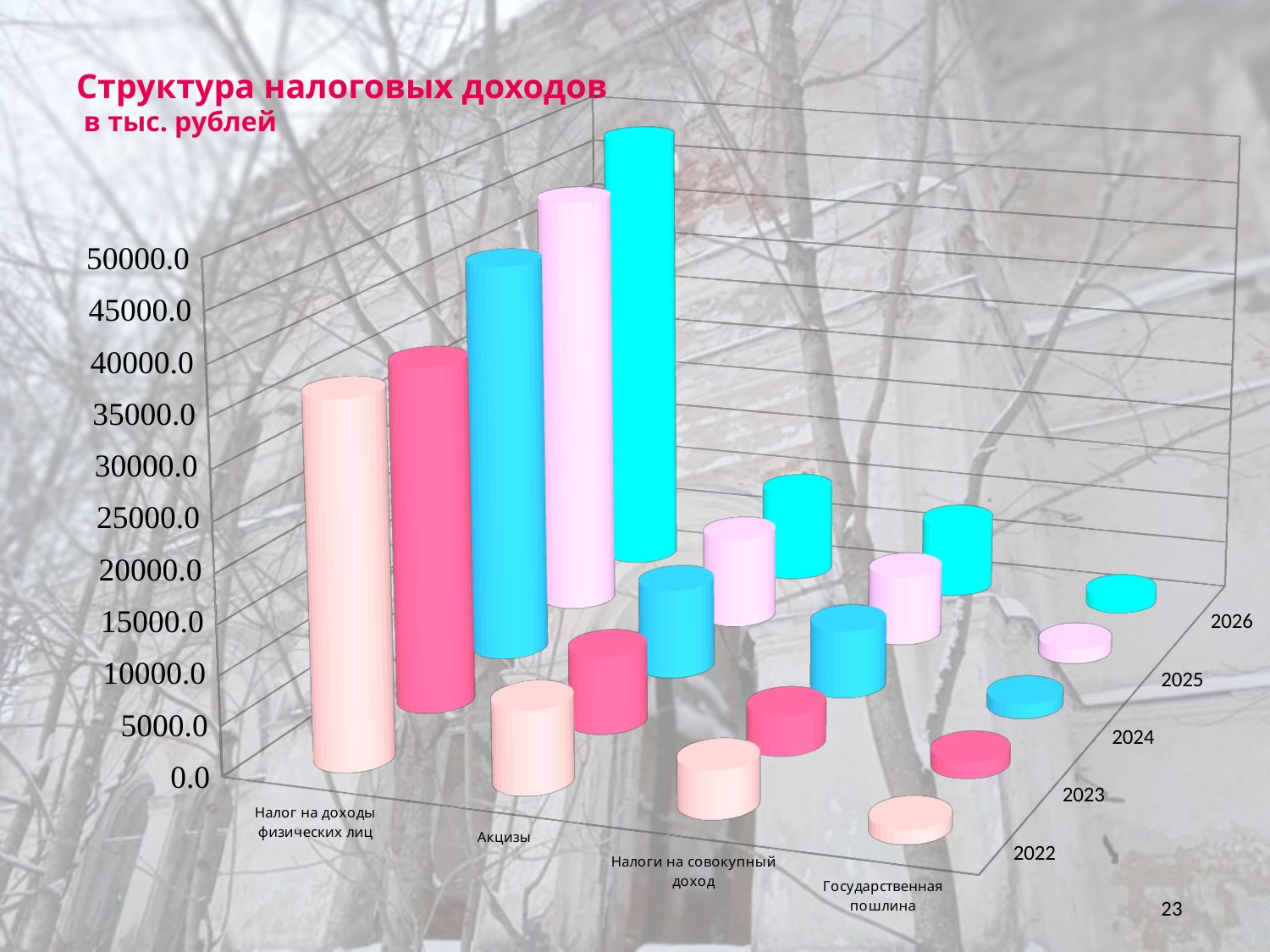
Is the value for Государственная пошлина in 2022 greater or less than 5000.0? less How many years (series) are plotted in the chart? 5 What kind of chart is shown on the slide? bar chart Which is larger in 2026: Налог на доходы физических лиц or Акцизы? Налог на доходы физических лиц Is the value for Налог на доходы физических лиц in 2022 greater or less than 30000.0? greater Do the values for Налог на доходы физических лиц rise or fall from 2022 to 2026? rise How many tax categories are shown along the category axis? 4 What is the title of the chart? Структура налоговых доходов в тыс. рублей Which tax category has the highest values in the chart? Налог на доходы физических лиц Is the value for Налоги на совокупный доход in 2022 greater or less than 10000.0? less Which tax category has the lowest values in the chart? Государственная пошлина What is the highest value shown on the vertical axis? 50000.0